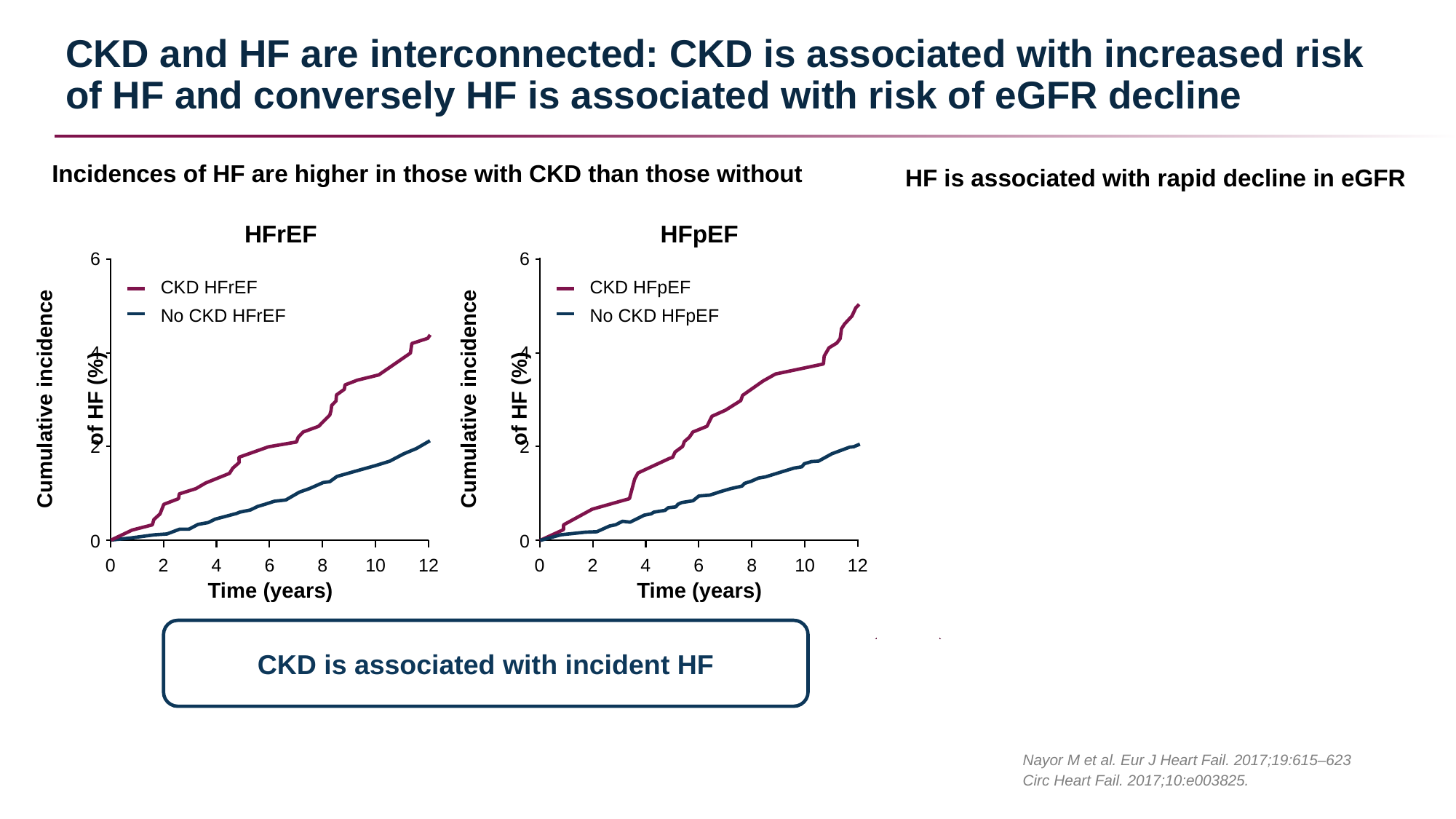
In the HFpEF chart, is the value for CKD HFpEF at 12 years greater or less than 4? greater What kind of chart is the HFrEF chart? line chart In the HFrEF chart, do the values for CKD HFrEF rise or fall as time increases? rise How many series does the legend of the HFpEF chart list? 2 In the HFpEF chart, which series is higher at 8 years, CKD HFpEF or No CKD HFpEF? CKD HFpEF In the HFpEF chart, is the value for No CKD HFpEF at 12 years greater or less than 4? less What is the x-axis label of the HFpEF chart? Time (years) In the HFrEF chart, is the value for No CKD HFrEF at 12 years greater or less than 4? less What are the two legend entries in the HFrEF chart? CKD HFrEF and No CKD HFrEF In the HFrEF chart, which series is higher at 12 years, CKD HFrEF or No CKD HFrEF? CKD HFrEF